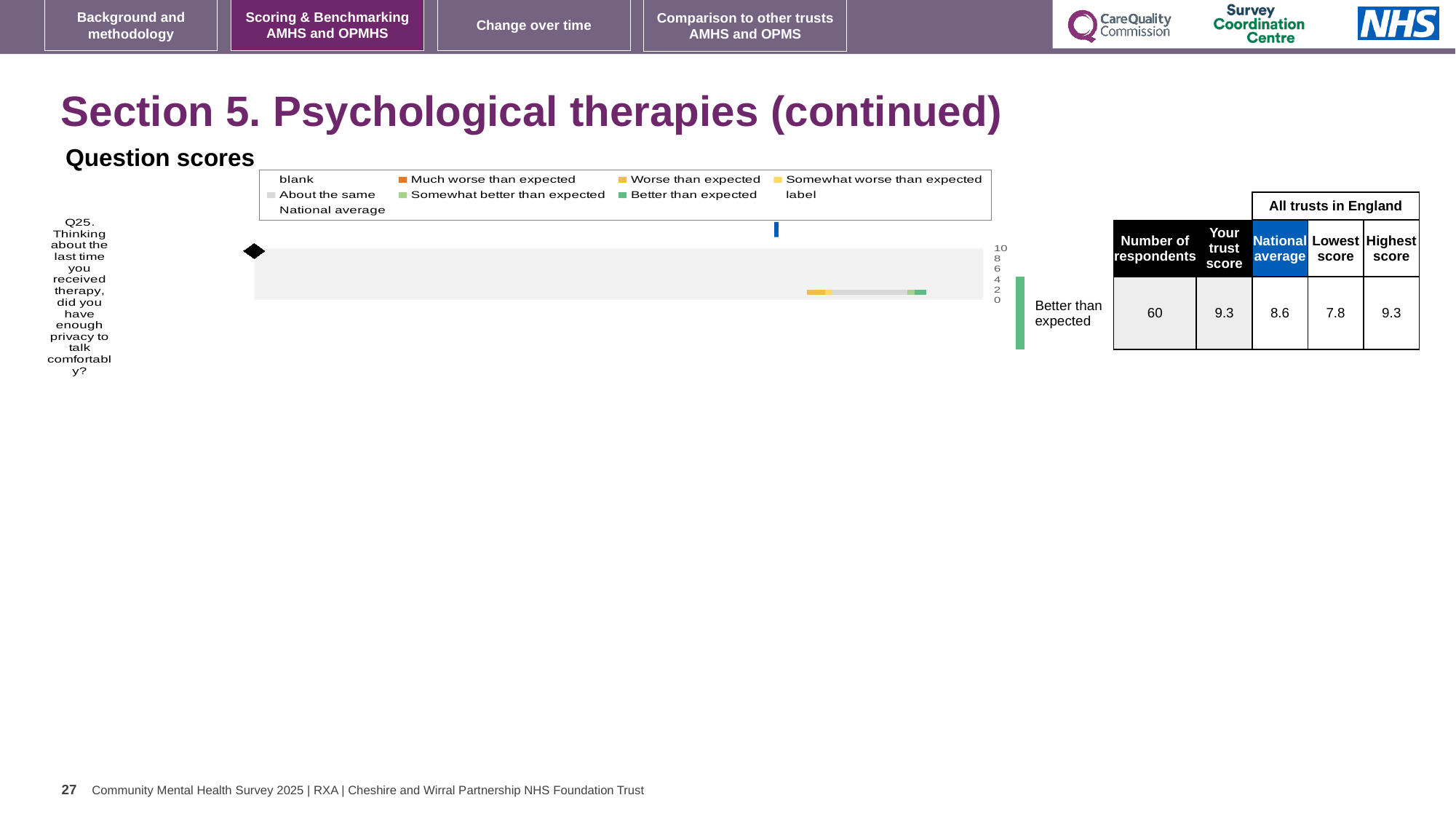
In the table beside the chart, what is "Your trust score" for Q25? 9.3 In the table beside the chart, what is the difference between the highest score and the lowest score for Q25? 1.5 How many survey questions are plotted in the "Question scores" chart? 1 How many entries does the legend of the "Question scores" chart list? 9 In the table beside the chart, which is larger for Q25: your trust score or the national average? Your trust score What kind of chart is shown under the heading "Question scores"? bar chart In the table beside the chart, what is the lowest score among all trusts in England for Q25? 7.8 What benchmark category label is shown to the right of the bar for Q25? Better than expected What colour represents "Better than expected" in the legend of the "Question scores" chart? green Which question number is plotted in the "Question scores" chart? Q25 In the table beside the chart, how many respondents answered Q25? 60 In the table beside the chart, what is the national average for Q25? 8.6